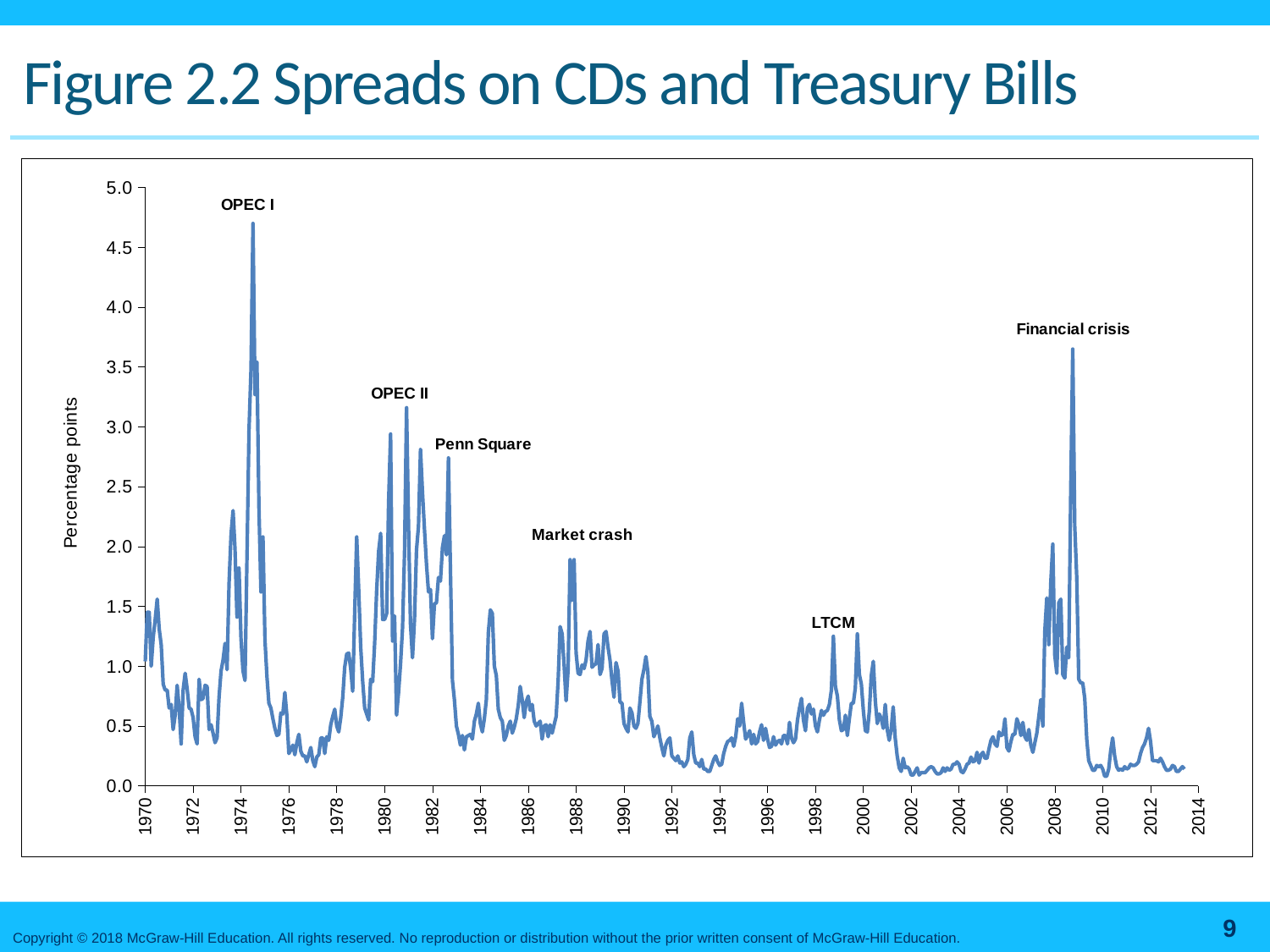
Is the peak value at OPEC I greater or less than 4.0 percentage points? greater Is the peak value at the Financial crisis greater or less than 3.0 percentage points? greater Is the peak value at LTCM greater or less than 1.5 percentage points? less What is the label on the vertical axis of the chart? Percentage points Which annotated event corresponds to the highest peak in the spread? OPEC I What kind of chart is shown on the slide? line chart How many labeled events are annotated on the chart? 6 Which peak is higher, OPEC I or Financial crisis? OPEC I Which peak is higher, Market crash or Penn Square? Penn Square Which annotated event corresponds to the lowest peak in the spread? LTCM Does the spread generally rise or fall between 2009 and 2013? fall What is the title of the chart on the slide? Figure 2.2 Spreads on CDs and Treasury Bills